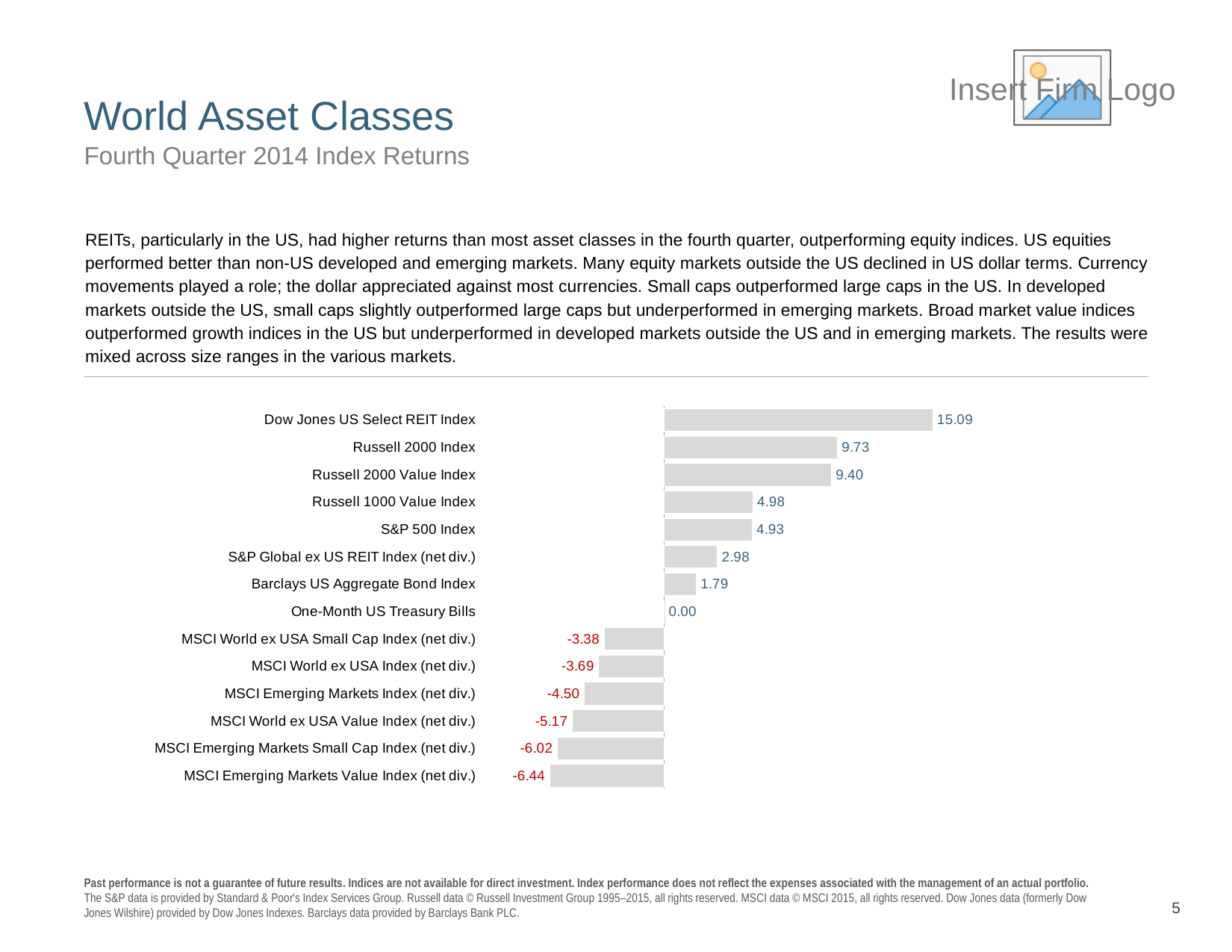
Which index has the highest return on the chart? Dow Jones US Select REIT Index Which is larger, the value for the S&P 500 Index or the S&P Global ex US REIT Index (net div.)? S&P 500 Index What kind of chart is shown on the slide? Bar chart What is the value for the Dow Jones US Select REIT Index? 15.09 Do the values decrease or increase going from the top bar to the bottom bar? Decrease What is the value for the MSCI Emerging Markets Index (net div.)? -4.50 How many indices are shown on the chart? 14 What is the difference between the Dow Jones US Select REIT Index and the Russell 2000 Index values? 5.36 Which index has the lowest return on the chart? MSCI Emerging Markets Value Index (net div.) What is the value for the Barclays US Aggregate Bond Index? 1.79 What is the value for One-Month US Treasury Bills? 0.00 What is the difference between the Russell 2000 Index and the Russell 2000 Value Index values? 0.33